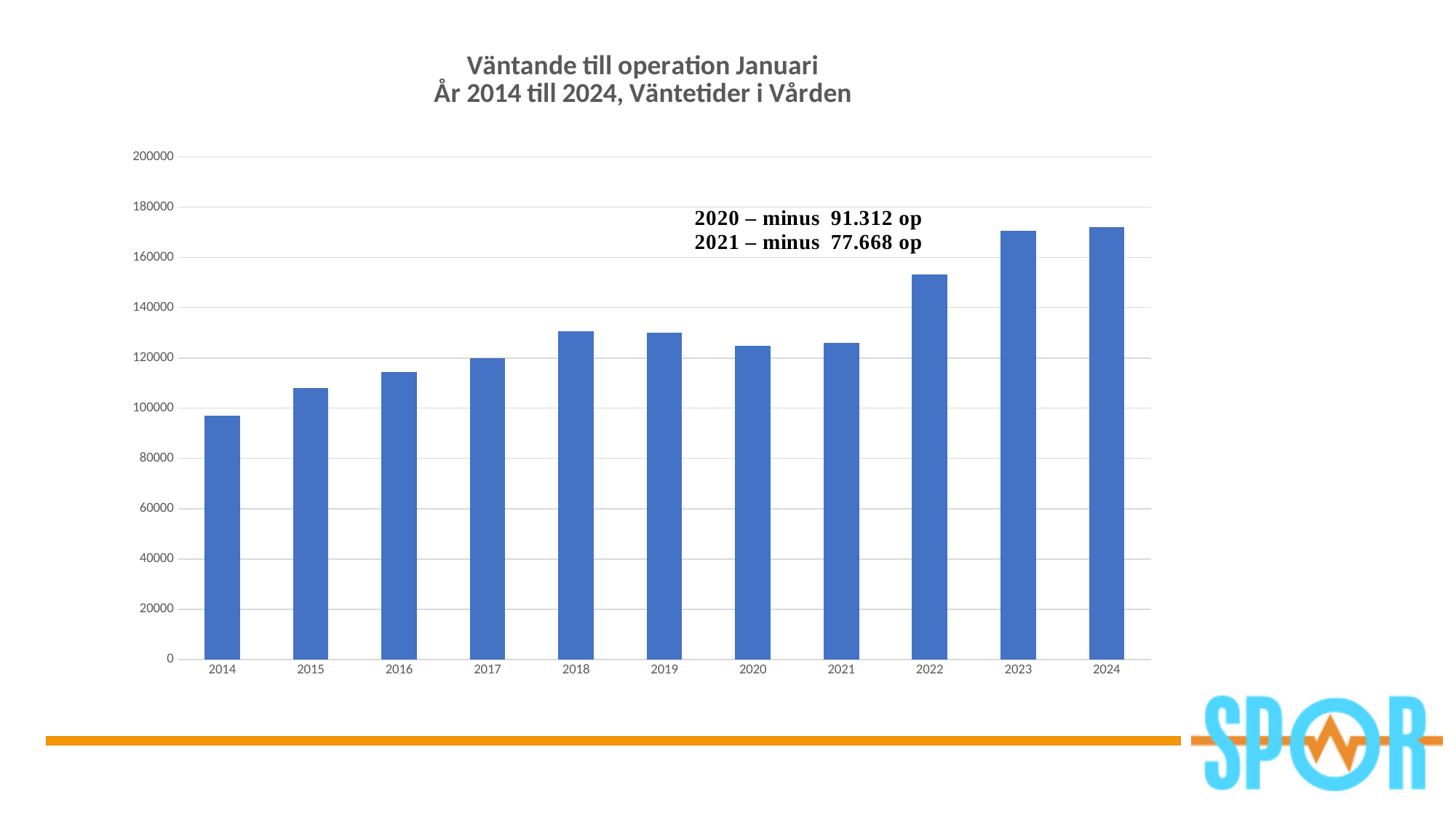
Is the value for 2022 greater or less than 140000? greater What kind of chart is shown on the slide? bar chart Is the value for 2014 greater or less than 100000? less Is the value for 2020 greater or less than 120000? greater Which is larger, the value for 2021 or the value for 2022? 2022 Do the values generally rise or fall from 2014 to 2024? rise According to the annotation on the chart, how many operations fewer are noted for 2020? 91.312 op Which year has the lowest bar in the chart? 2014 Which is larger, the value for 2014 or the value for 2015? 2015 How many years are plotted on the x axis of the chart? 11